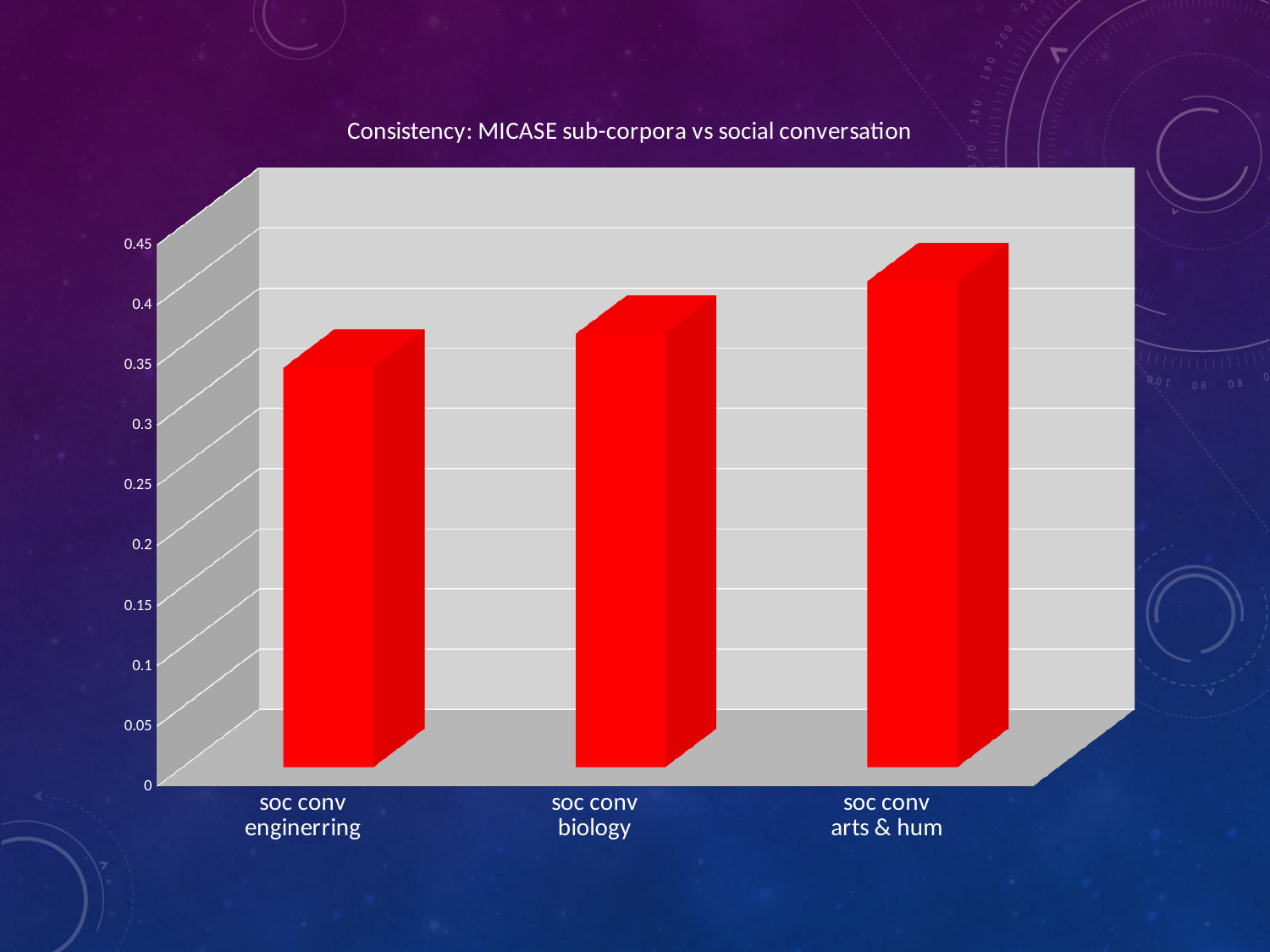
Is the value for soc conv arts & hum greater or less than 0.35? greater What colour are the bars in the chart? red Which is larger, the value for soc conv biology or the value for soc conv enginerring? soc conv biology Is the value for soc conv enginerring greater or less than 0.3? greater Which is larger, the value for soc conv arts & hum or the value for soc conv biology? soc conv arts & hum Which category has the highest value? soc conv arts & hum Do the values rise or fall from left to right across the categories? rise What kind of chart is shown on the slide? bar chart Is the value for soc conv enginerring greater or less than 0.4? less How many categories are plotted in the chart? 3 Which category has the lowest value? soc conv enginerring What is the title of the chart? Consistency: MICASE sub-corpora vs social conversation